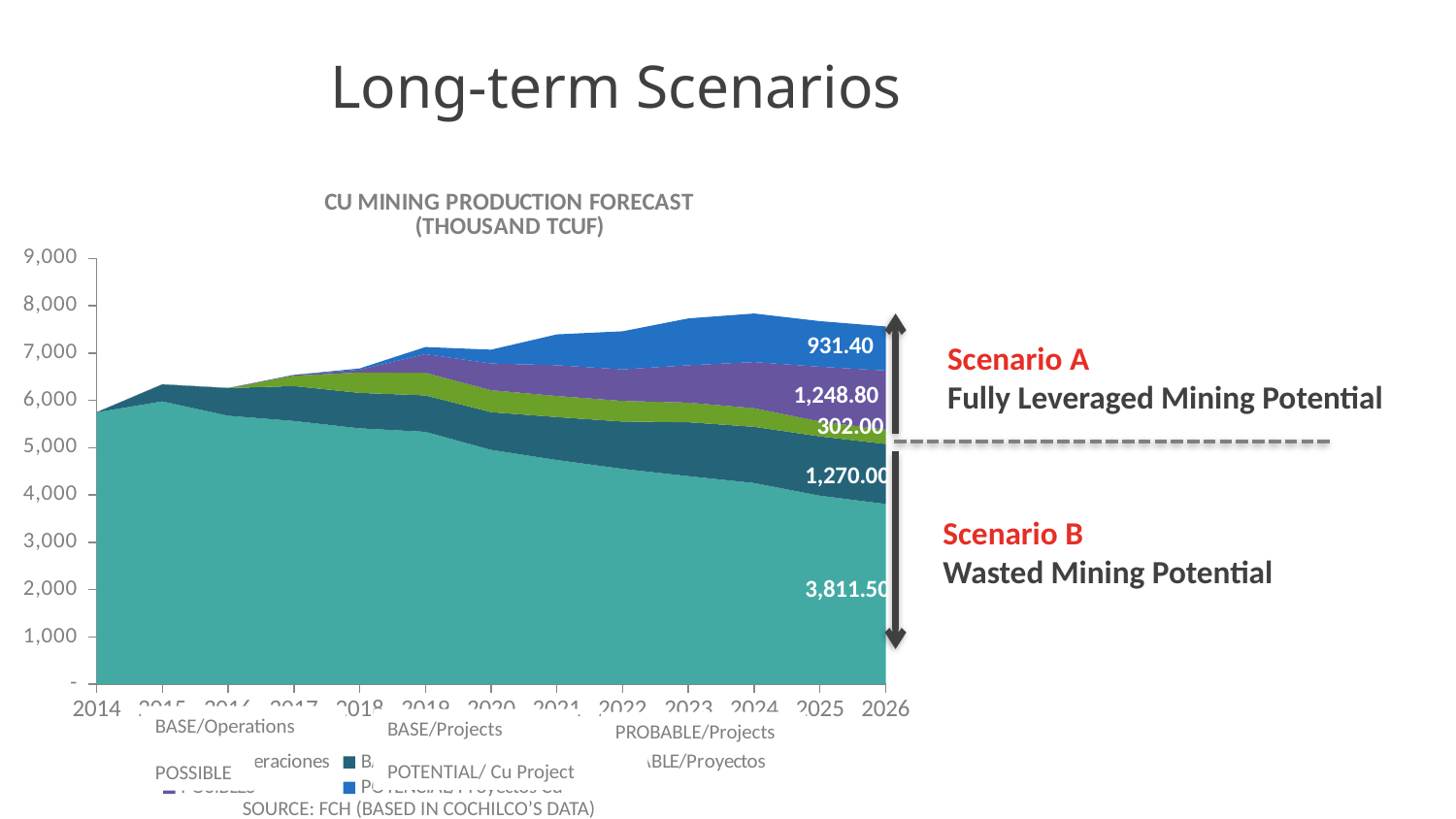
What is the value labelled for POSSIBLE in 2026? 1,248.80 How many years are shown on the x axis? 13 What is the value labelled for BASE/Operations in 2026? 3,811.50 What is the difference between the 2026 values for BASE/Operations and BASE/Projects? 2,541.50 What is the value labelled for POTENTIAL/ Cu Project in 2026? 931.40 What kind of chart is shown on the slide? Stacked area chart What is the title of the chart? CU MINING PRODUCTION FORECAST (THOUSAND TCUF) Which of the labelled 2026 values is the smallest? PROBABLE/Projects (302.00) How many series does the legend list? 5 What is the value labelled for BASE/Projects in 2026? 1,270.00 What is the total of the labelled 2026 values across all series? 7,563.70 What is the value labelled for PROBABLE/Projects in 2026? 302.00